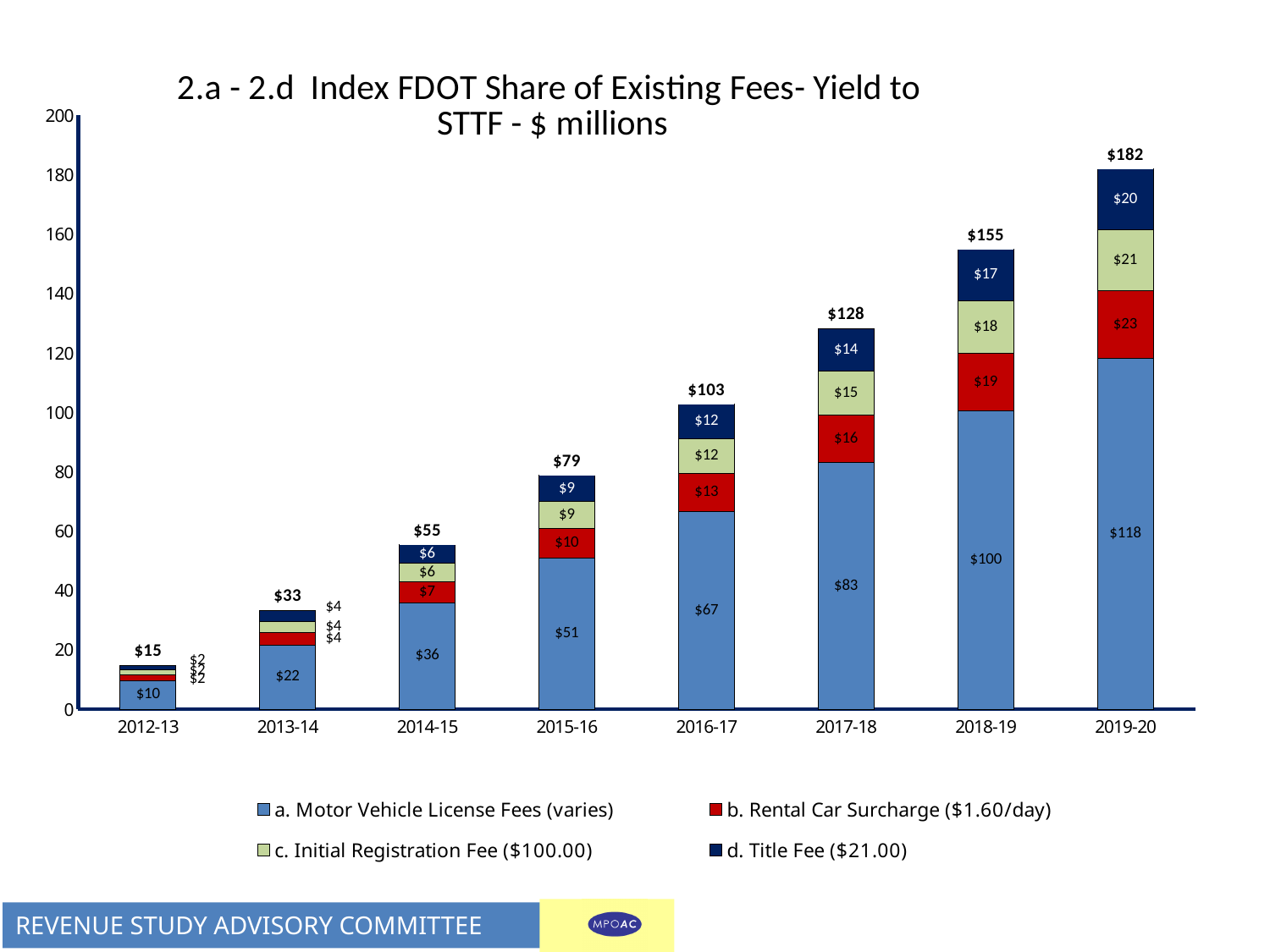
How many series does the legend list? 4 Do the bar totals rise or fall from 2012-13 to 2019-20? Rise What type of chart is shown on the slide? Stacked bar chart Which is larger, the Initial Registration Fee value in 2016-17 or in 2014-15? 2016-17 Which fiscal year has the lowest total? 2012-13 Which fiscal year has the highest total? 2019-20 What is the difference between the Motor Vehicle License Fees values for 2018-19 and 2017-18? $17 What is the total labeled for the 2015-16 bar? $79 What is the value for Motor Vehicle License Fees in 2019-20? $118 What is the value for Rental Car Surcharge in 2017-18? $16 What is the value for Title Fee in 2018-19? $17 How many fiscal years are shown on the x axis? 8